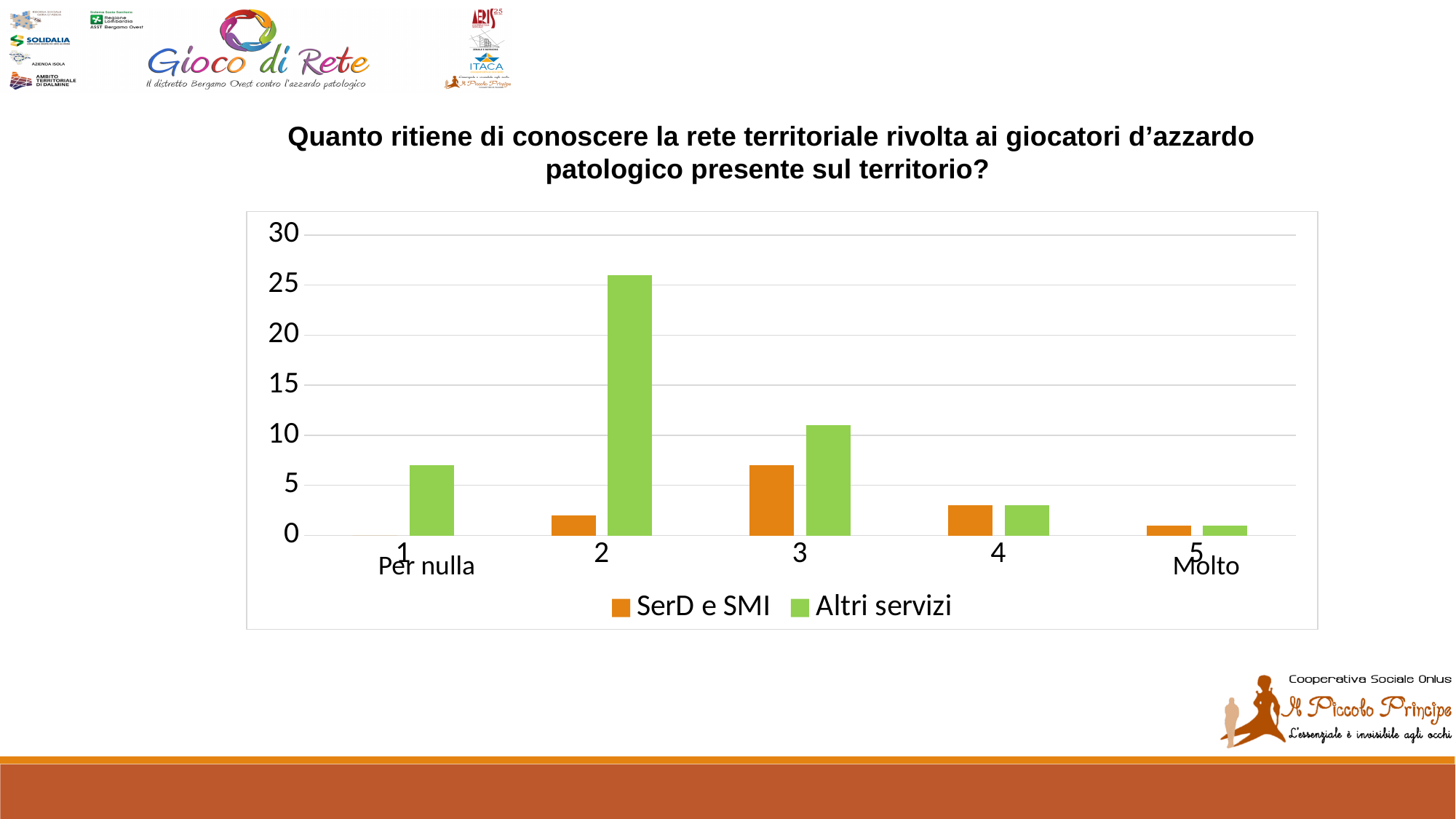
Is the Altri servizi value for category 2 greater or less than 20? greater For which category is the Altri servizi value highest? 2 Which colour represents the Altri servizi series in the legend? green Is the SerD e SMI value for category 2 greater or less than 5? less For which category is the SerD e SMI value highest? 3 How many categories are shown on the x axis? 5 What kind of chart is shown on the slide? bar chart How many series does the legend list? 2 For category 3, which series has the larger value, SerD e SMI or Altri servizi? Altri servizi Do the Altri servizi values rise or fall from category 2 to category 5? fall For which category is the Altri servizi value lowest? 5 (Molto) Is the Altri servizi value for category 1 (Per nulla) greater or less than 5? greater